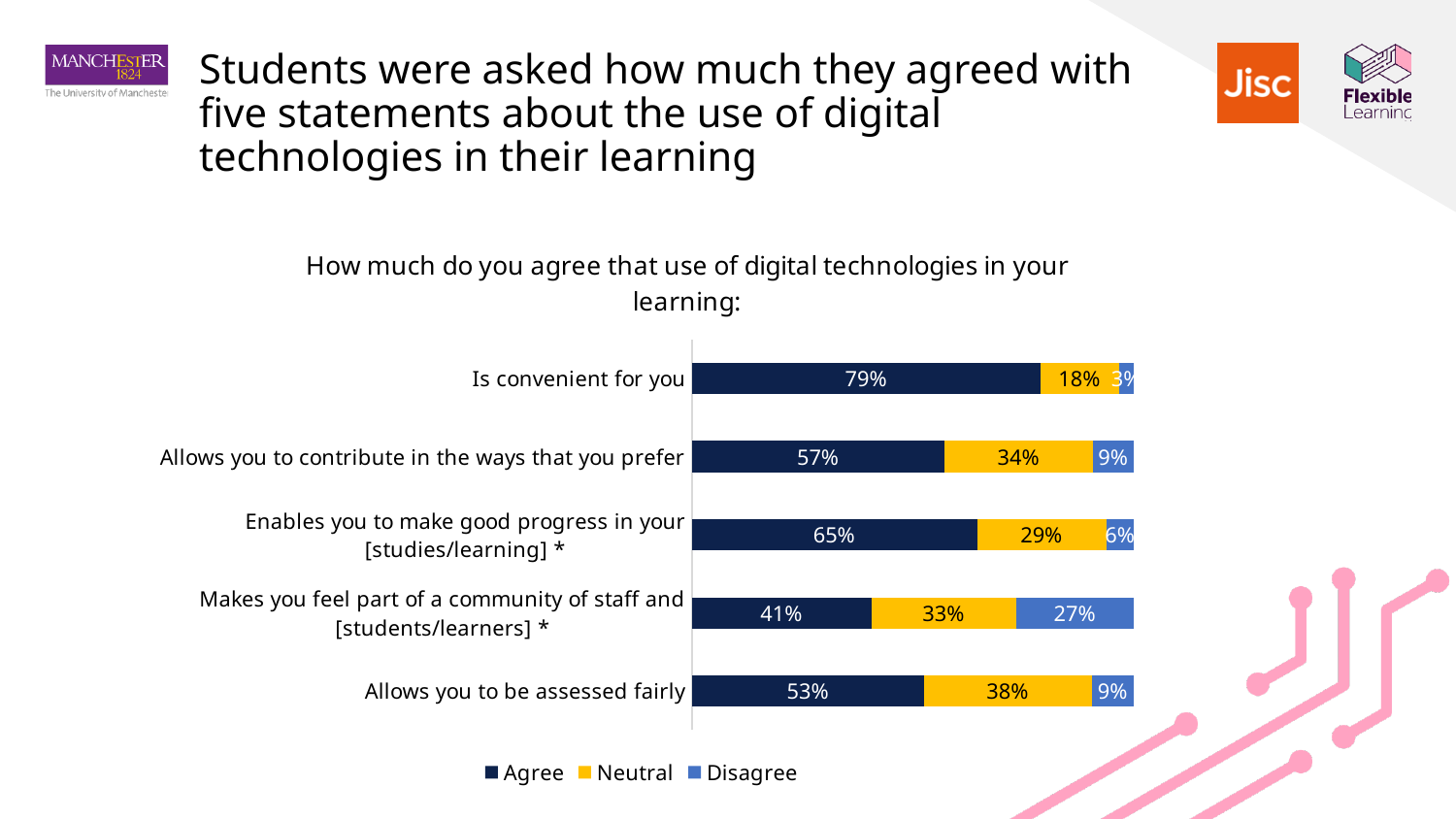
How many series does the legend list? 3 What percentage of students disagreed that digital technologies make them feel part of a community of staff and students/learners? 27% Which series is shown in yellow in the chart? Neutral What is the Neutral value for 'Allows you to be assessed fairly'? 38% Which has a larger Neutral value: 'Allows you to contribute in the ways that you prefer' or 'Enables you to make good progress in your [studies/learning]'? Allows you to contribute in the ways that you prefer What percentage of students agreed that use of digital technologies in their learning is convenient for them? 79% What kind of chart is shown on the slide? Stacked bar chart What is the Agree value for 'Enables you to make good progress in your [studies/learning]'? 65% How many statements are shown in the chart? 5 What is the difference between the Agree percentages for 'Is convenient for you' and 'Allows you to be assessed fairly'? 26% Which statement has the lowest Agree percentage? Makes you feel part of a community of staff and [students/learners] Which statement has the highest Agree percentage? Is convenient for you